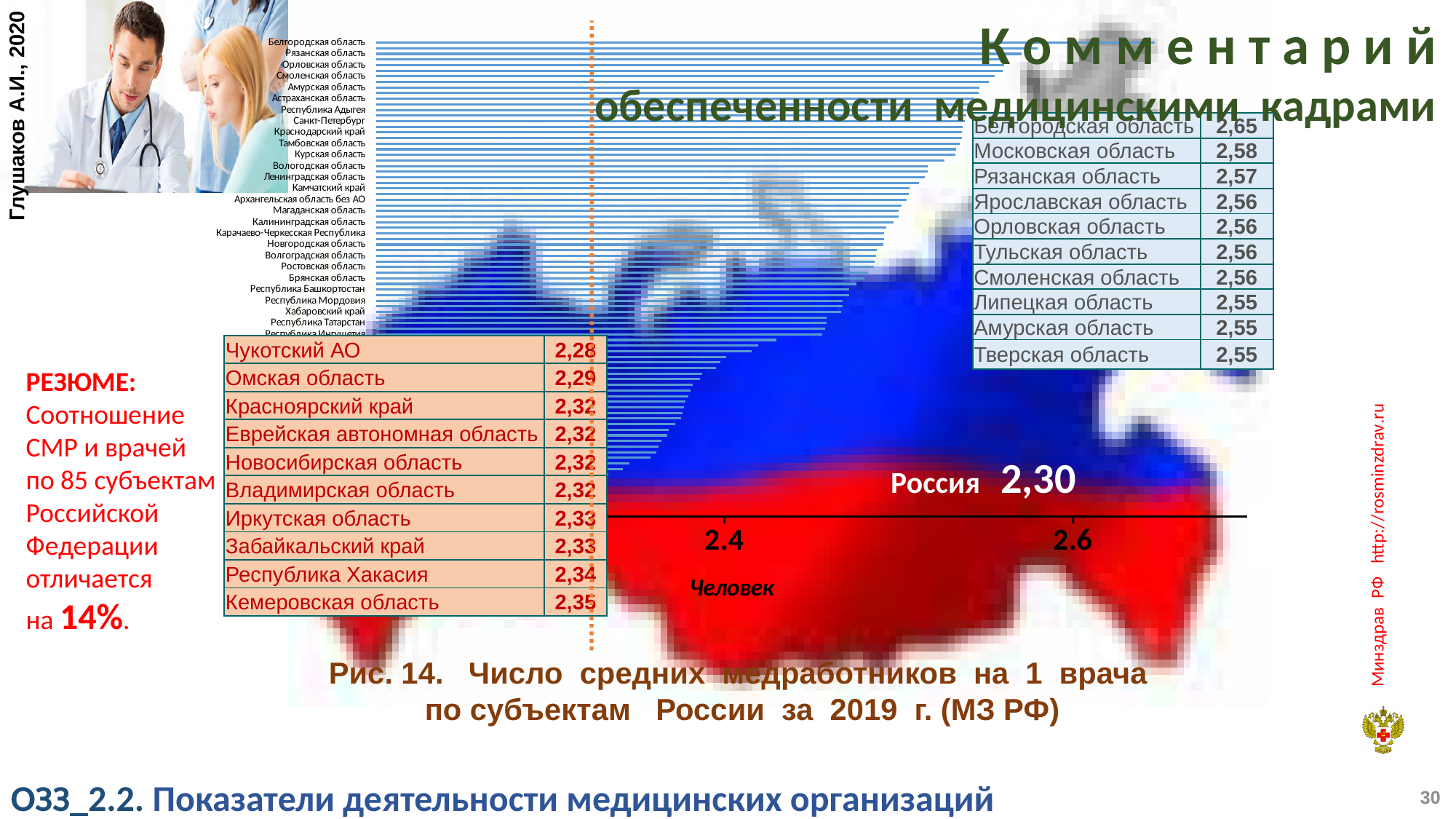
Which region has the highest value among those listed in the tables? Белгородская область What is the value for Московская область? 2,58 What is the difference between the values for Кемеровская область and Чукотский АО? 0,07 What unit label is shown under the x axis of the chart? Человек What is the value for Белгородская область in the upper table? 2,65 What is the value shown for Россия on the chart? 2,30 Which has the larger value, Омская область or Кемеровская область? Кемеровская область What kind of chart is shown on the slide (Рис. 14)? bar chart How many regions are listed in the lower (orange) table? 10 What is the difference between the values for Белгородская область and Чукотский АО? 0,37 Which region has the lowest value among those listed in the tables? Чукотский АО What is the value for Чукотский АО in the lower table? 2,28